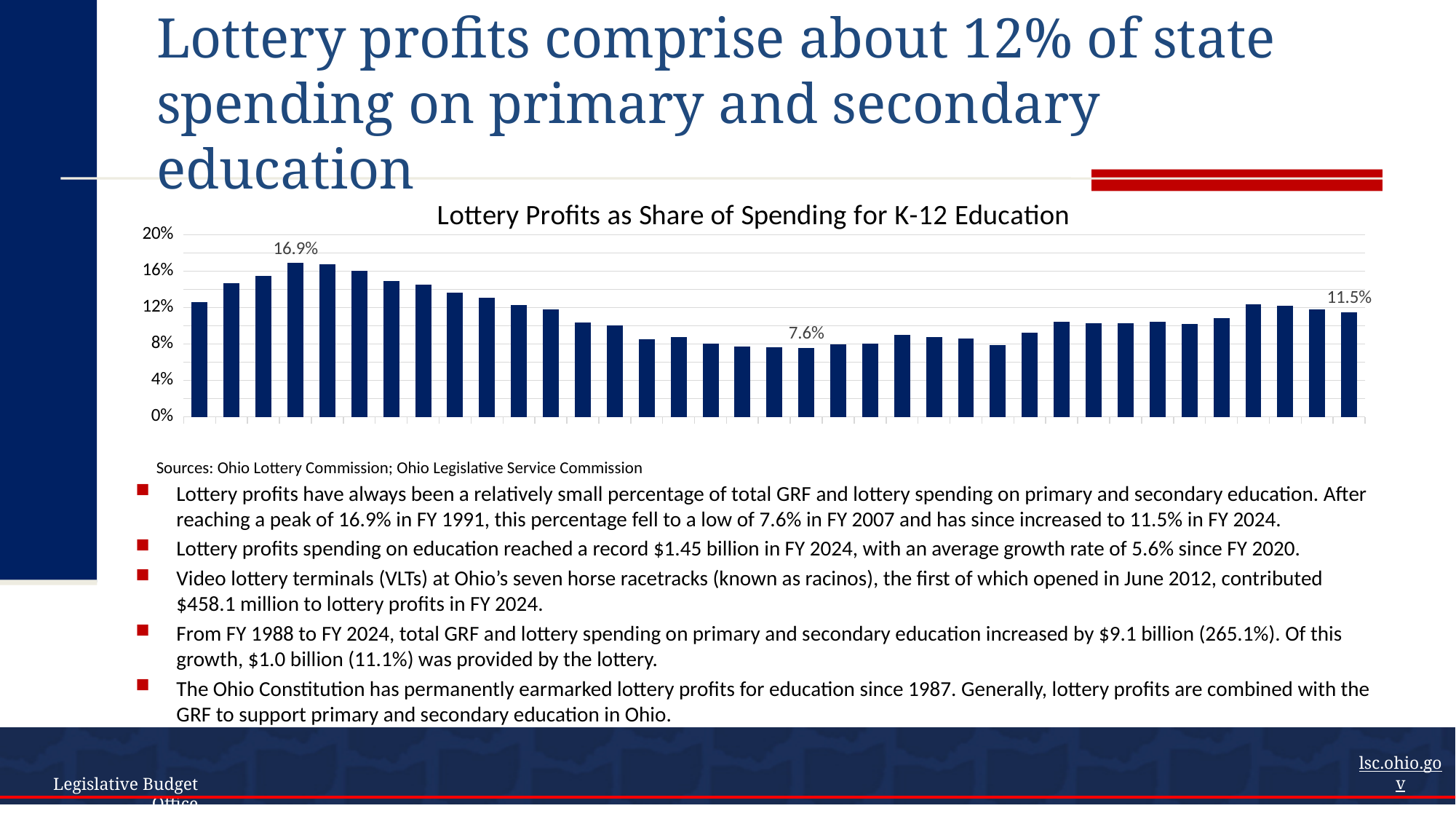
What colour are the bars in the chart? Dark blue What is the value of the rightmost (last) bar in the chart? 11.5% How many bars are plotted in the chart? 37 What is the value of the highest bar in the chart? 16.9% What kind of chart is shown on the slide? Bar chart Is the value of the leftmost bar greater or less than 8%? greater Is the value of the leftmost bar greater or less than 16%? less What is the difference between the highest bar (16.9%) and the rightmost bar (11.5%)? 5.4 percentage points What is the title of the chart? Lottery Profits as Share of Spending for K-12 Education What is the value of the lowest bar in the chart? 7.6% Do the bar values generally rise or fall from the highest bar to the lowest bar? fall What is the difference between the highest bar (16.9%) and the lowest bar (7.6%)? 9.3 percentage points